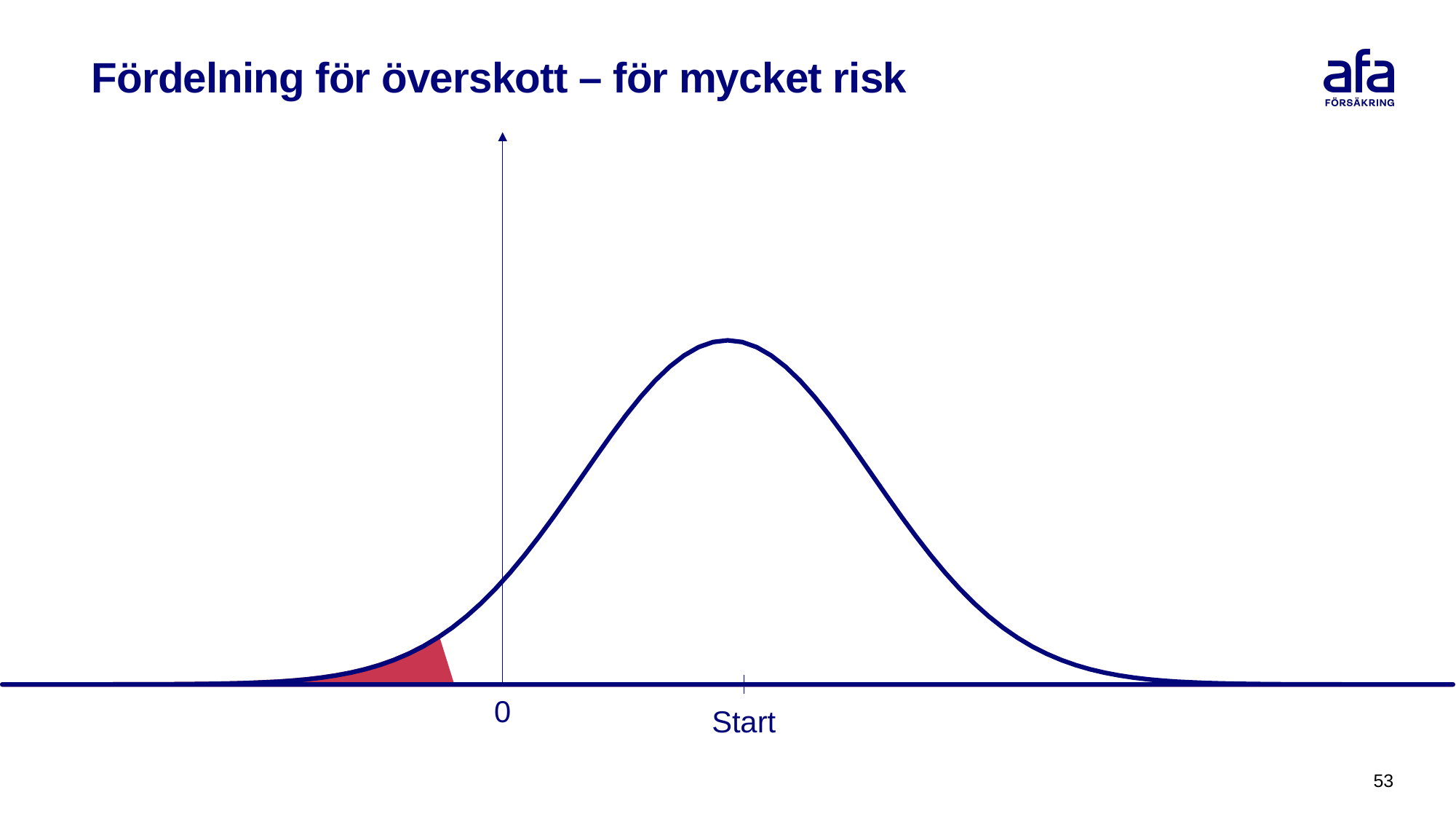
What is the title of the chart on the slide? Fördelning för överskott – för mycket risk What kind of chart is shown on the slide? line chart (a bell-shaped distribution curve) Is the curve higher at the x-axis label "Start" or at the label "0"? Start How many labelled tick marks are there on the x axis? 2 Is the red shaded area located to the left or to the right of the x-axis label "0"? left Above which x-axis label does the curve reach its peak? Start Moving from left to right along the x axis, does the curve rise and then fall, or fall and then rise? rise and then fall What are the two labels shown on the x axis? 0 and Start